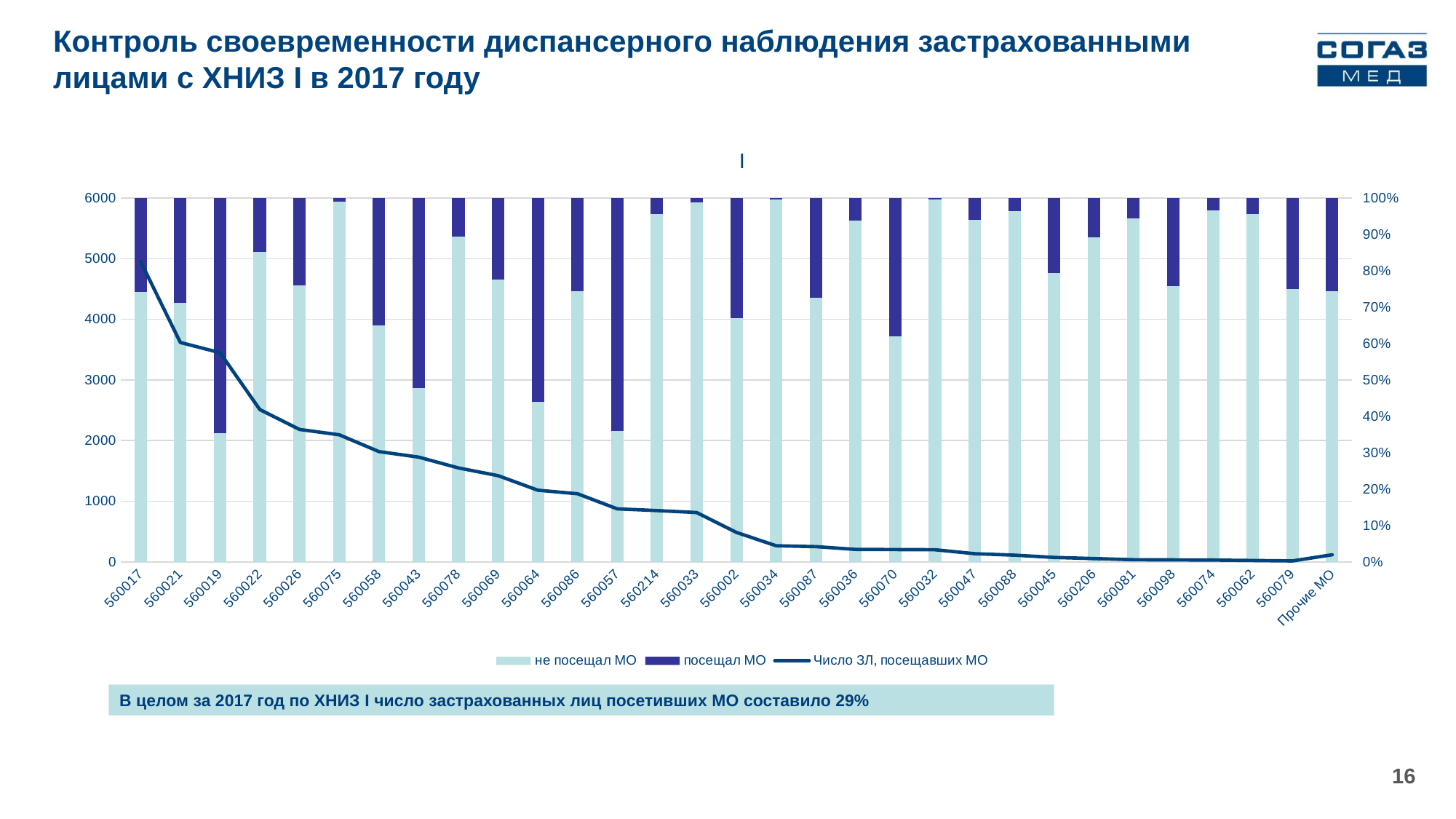
How many series does the legend list? 3 Does the line "Число ЗЛ, посещавших МО" rise or fall from left to right along the x axis? Falls Is the value of the line "Число ЗЛ, посещавших МО" for 560021 greater or less than 3000? greater Is the share of "не посещал МО" for 560019 greater or less than 50%? less Is the value of the line "Число ЗЛ, посещавших МО" for 560017 greater or less than 4000? greater What are the three legend entries of the chart? не посещал МО, посещал МО, Число ЗЛ, посещавших МО How many categories are shown along the x axis? 31 Which category has the highest value on the line "Число ЗЛ, посещавших МО"? 560017 What kind of chart is shown on the slide? A stacked bar chart combined with a line Which is larger: the line value "Число ЗЛ, посещавших МО" for 560017 or for 560021? 560017